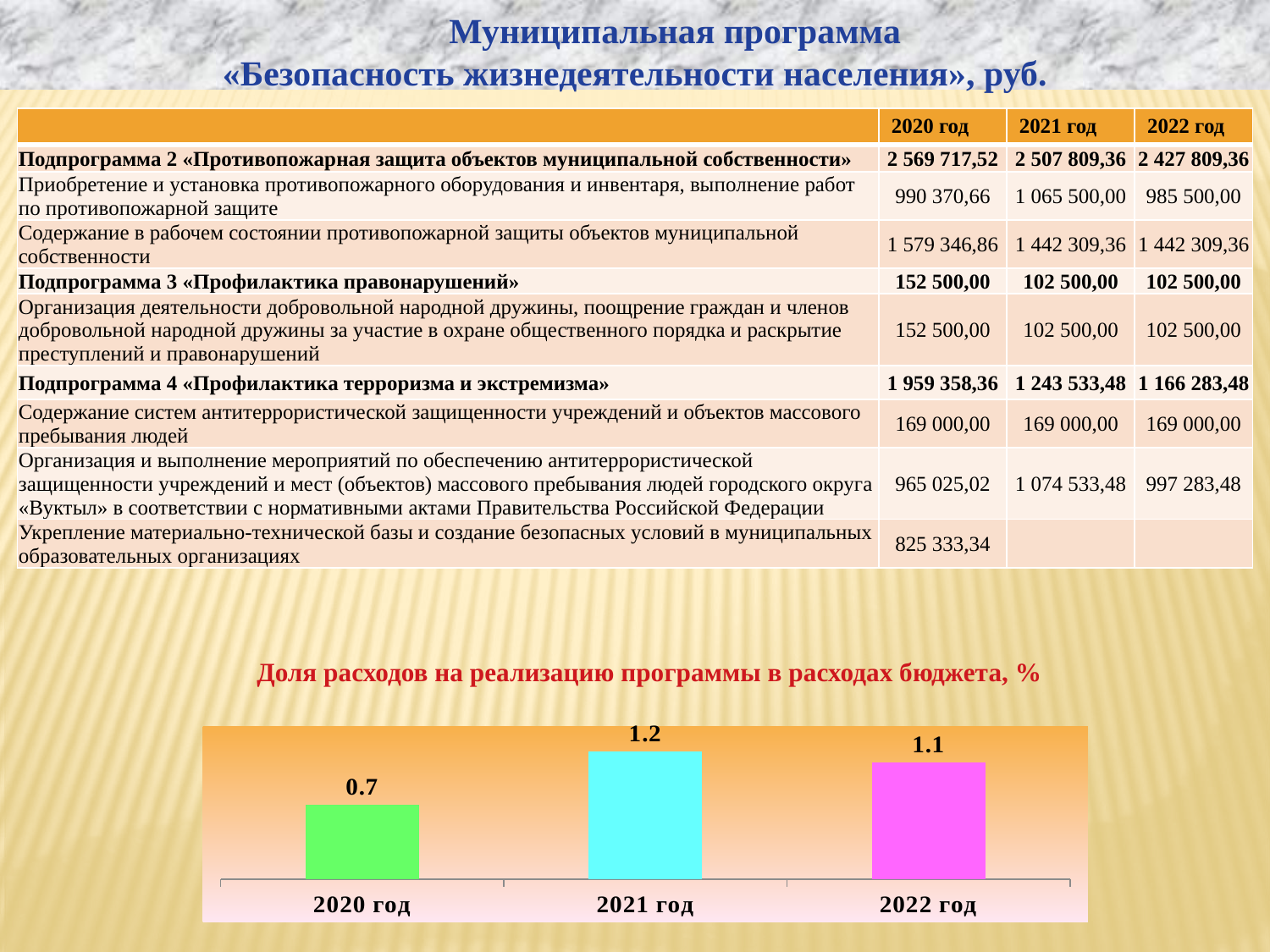
What is the value for 2021 год in the chart 'Доля расходов на реализацию программы в расходах бюджета, %'? 1.2 In the chart 'Доля расходов на реализацию программы в расходах бюджета, %', what is the difference between the values for 2021 год and 2022 год? 0.1 What is the value for 2020 год in the chart 'Доля расходов на реализацию программы в расходах бюджета, %'? 0.7 Which year has the lowest value in the chart 'Доля расходов на реализацию программы в расходах бюджета, %'? 2020 год What colour is the bar for 2021 год in the chart 'Доля расходов на реализацию программы в расходах бюджета, %'? Cyan In the chart 'Доля расходов на реализацию программы в расходах бюджета, %', which is larger: the value for 2020 год or 2022 год? 2022 год How many bars are shown in the chart 'Доля расходов на реализацию программы в расходах бюджета, %'? 3 In the chart 'Доля расходов на реализацию программы в расходах бюджета, %', what is the difference between the values for 2021 год and 2020 год? 0.5 In the chart 'Доля расходов на реализацию программы в расходах бюджета, %', does the value rise or fall from 2020 год to 2021 год? Rise What is the value for 2022 год in the chart 'Доля расходов на реализацию программы в расходах бюджета, %'? 1.1 What type of chart is 'Доля расходов на реализацию программы в расходах бюджета, %'? Bar chart Which year has the highest value in the chart 'Доля расходов на реализацию программы в расходах бюджета, %'? 2021 год